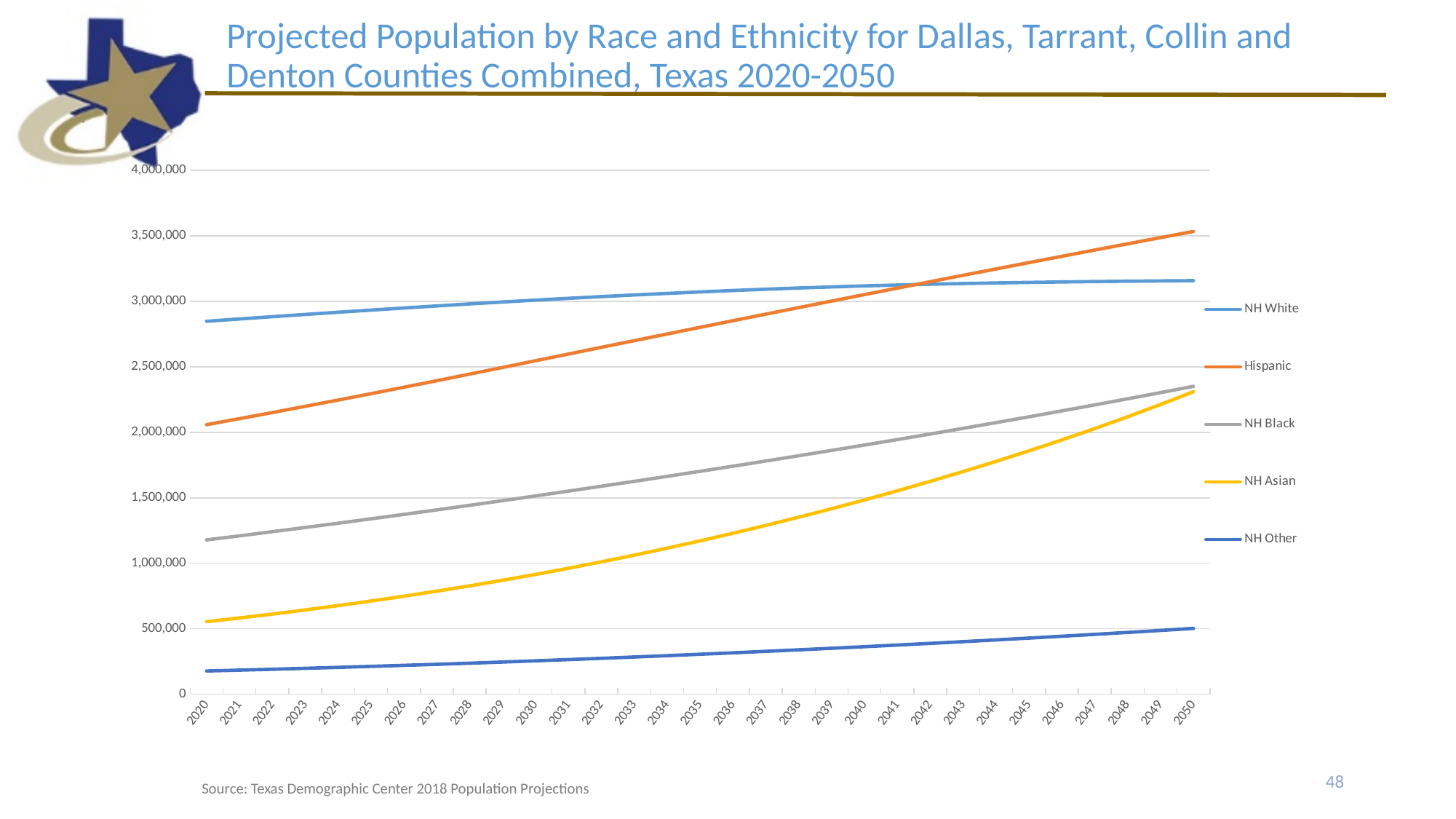
How many years are shown along the x axis? 31 Does the projected Hispanic population rise or fall from 2020 to 2050? rise Which four counties does the chart title say are combined? Dallas, Tarrant, Collin and Denton In 2020, which is larger: the NH White population or the Hispanic population? NH White Which group has the lowest projected population in 2050? NH Other How many series does the legend list? 5 Is the projected NH Asian population in 2020 greater or less than 1,000,000? less In 2050, which is larger: the Hispanic population or the NH White population? Hispanic What kind of chart is shown on the slide? Line chart Which group has the highest projected population in 2020? NH White Which group has the highest projected population in 2050? Hispanic Is the projected Hispanic population in 2050 greater or less than 3,000,000? greater